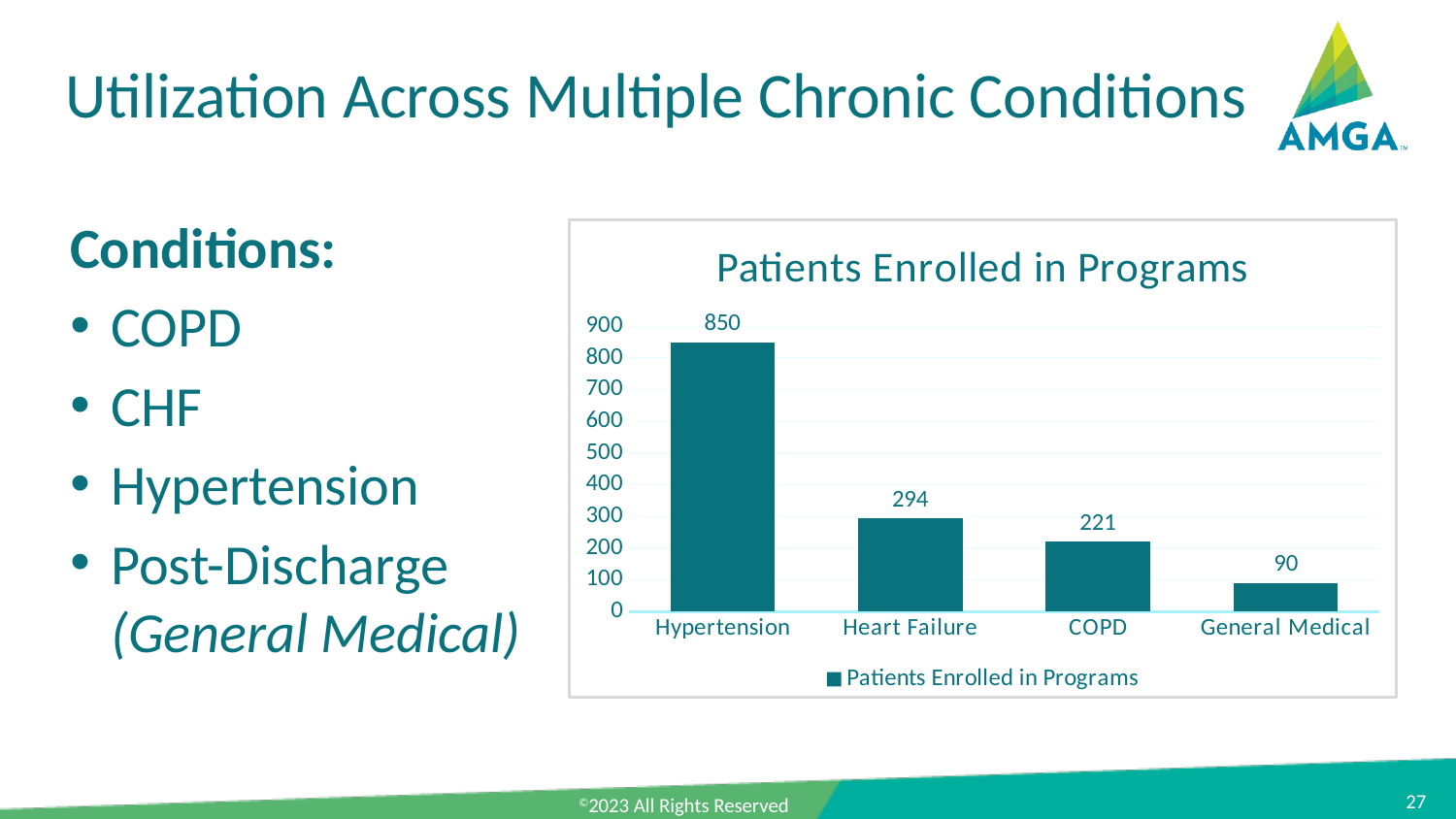
What is the difference between the Hypertension and Heart Failure values? 556 How many patients are enrolled in programs for Hypertension? 850 Which category has the lowest number of patients enrolled in programs? General Medical Which has more patients enrolled, Heart Failure or COPD? Heart Failure What type of chart is shown on the slide? Bar chart How many categories are shown on the x axis of the chart? 4 What is the difference between the COPD and General Medical values? 131 What is the value for General Medical? 90 Which category has the highest number of patients enrolled in programs? Hypertension How many patients are enrolled in programs for COPD? 221 What is the title of the chart? Patients Enrolled in Programs What is the value for Heart Failure in the Patients Enrolled in Programs chart? 294